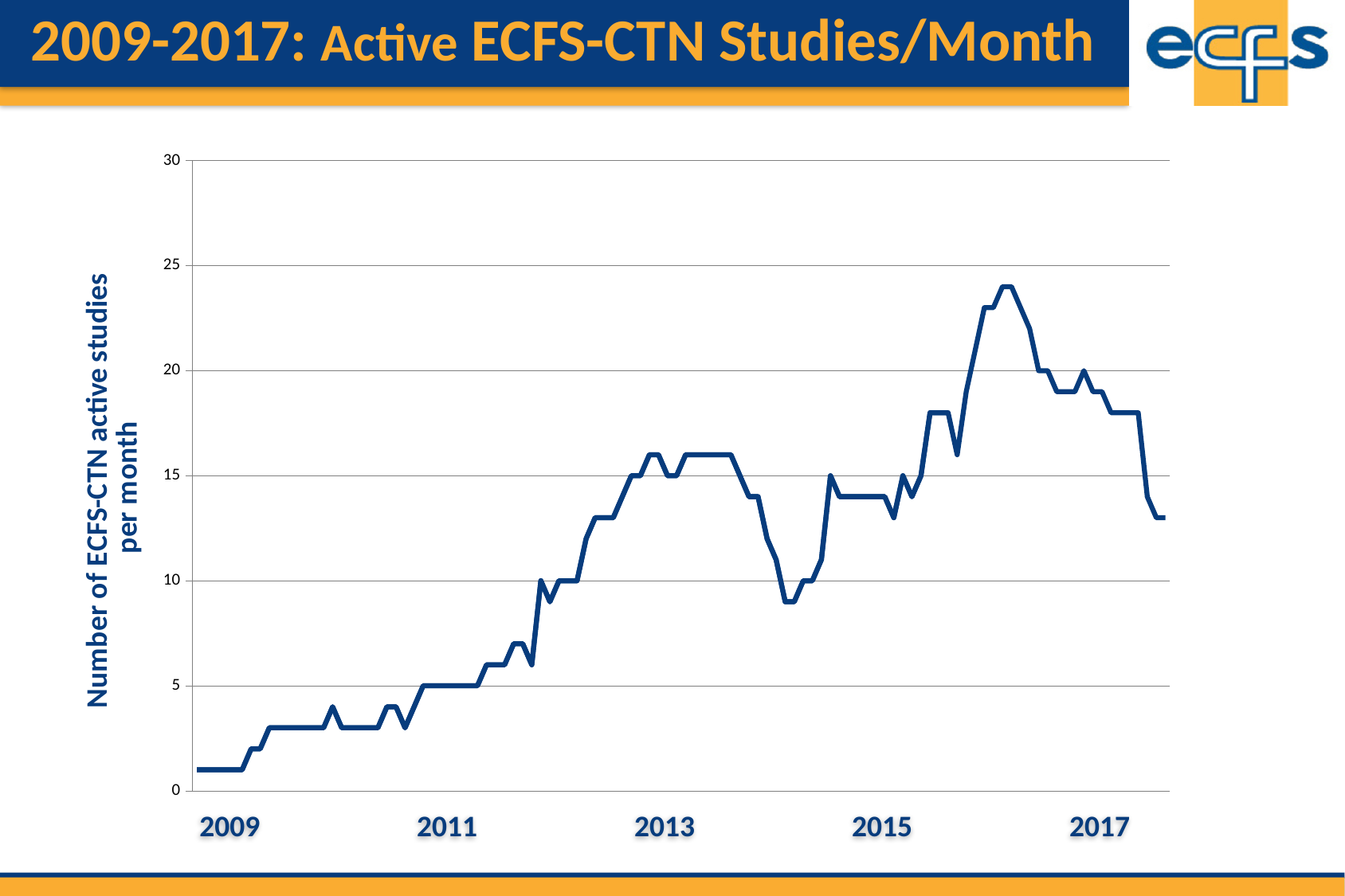
Which is higher: the peak of the line around 2016 or the peak around 2013? the peak around 2016 What kind of chart is shown on the slide? line chart Is the value at the 2015 tick greater or less than 10? greater What is the title of the chart on the slide? 2009-2017: Active ECFS-CTN Studies/Month Is the highest value reached by the line (around 2016) greater or less than 20? greater Is the lowest value in the dip during 2014 greater or less than 15? less Overall, does the number of active studies rise or fall from 2009 to 2017? rise Which is larger: the value at the 2009 tick or the value at the 2017 tick? 2017 How many year labels are shown on the horizontal axis? 5 What is the label on the vertical axis of the chart? Number of ECFS-CTN active studies per month